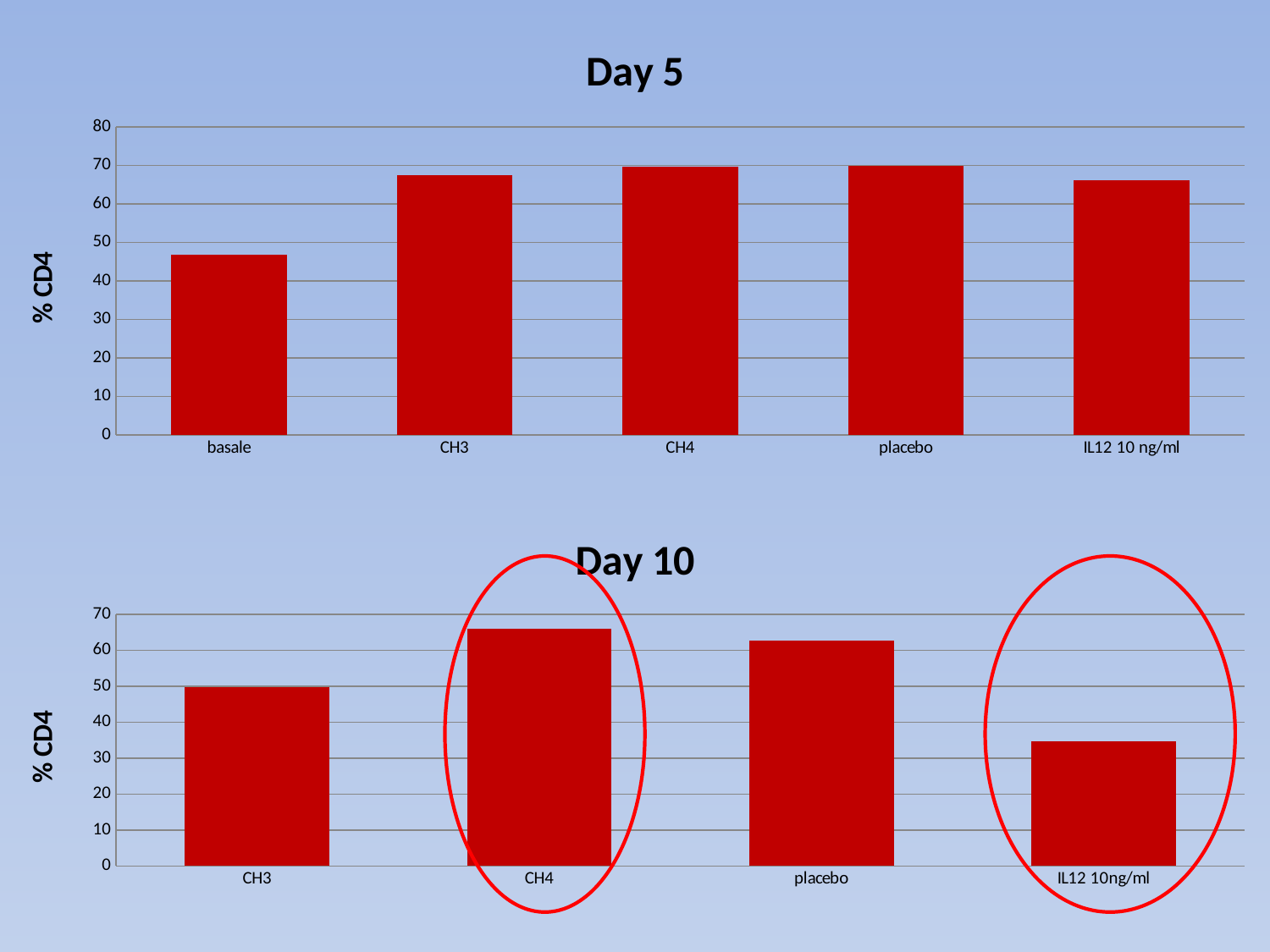
On the Day 10 chart, is the value for CH4 greater or less than 60? greater On the Day 10 chart, which is larger, the value for CH3 or the value for CH4? CH4 On the Day 10 chart, which category has the lowest % CD4? IL12 10ng/ml On the Day 5 chart, is the value for basale greater or less than 50? less On the Day 5 chart, which category has the lowest % CD4? basale What is the y-axis label on the Day 10 chart? % CD4 What kind of chart is the Day 5 chart? bar chart How many categories are shown on the Day 5 chart? 5 On the Day 10 chart, is the value for IL12 10ng/ml greater or less than 40? less On the Day 5 chart, which is larger, the value for basale or the value for CH3? CH3 How many categories are shown on the Day 10 chart? 4